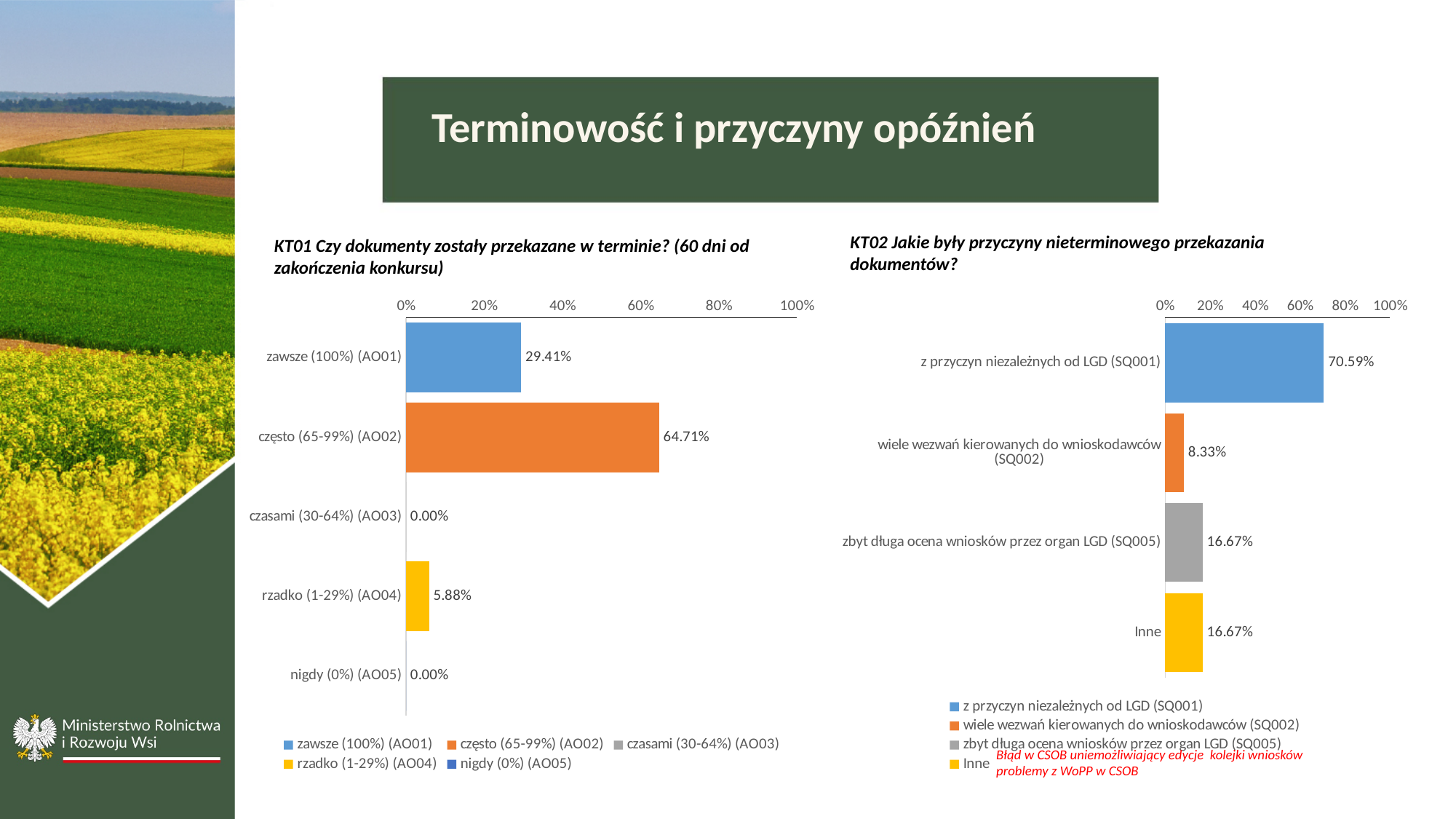
In the KT01 chart (left), what is the value for 'często (65-99%) (AO02)'? 64.71% In the KT01 chart (left), how many categories have a value of 0.00%? 2 In the KT02 chart (right), what is the value for 'z przyczyn niezależnych od LGD (SQ001)'? 70.59% In the KT02 chart (right), which is larger: 'zbyt długa ocena wniosków przez organ LGD (SQ005)' or 'wiele wezwań kierowanych do wnioskodawców (SQ002)'? zbyt długa ocena wniosków przez organ LGD (SQ005) What type of chart is the KT02 chart (right)? bar chart In the KT02 chart (right), what is the value for 'wiele wezwań kierowanych do wnioskodawców (SQ002)'? 8.33% In the KT01 chart (left), what is the difference between 'często (65-99%) (AO02)' and 'zawsze (100%) (AO01)'? 35.30% In the KT02 chart (right), is the value for 'z przyczyn niezależnych od LGD (SQ001)' greater or less than 60%? greater In the KT01 chart (left), which category has the highest value? często (65-99%) (AO02) In the KT01 chart (left), how many categories are shown on the vertical axis? 5 In the KT02 chart (right), which category has the lowest value? wiele wezwań kierowanych do wnioskodawców (SQ002) In the KT01 chart (left), what is the value for 'zawsze (100%) (AO01)'? 29.41%